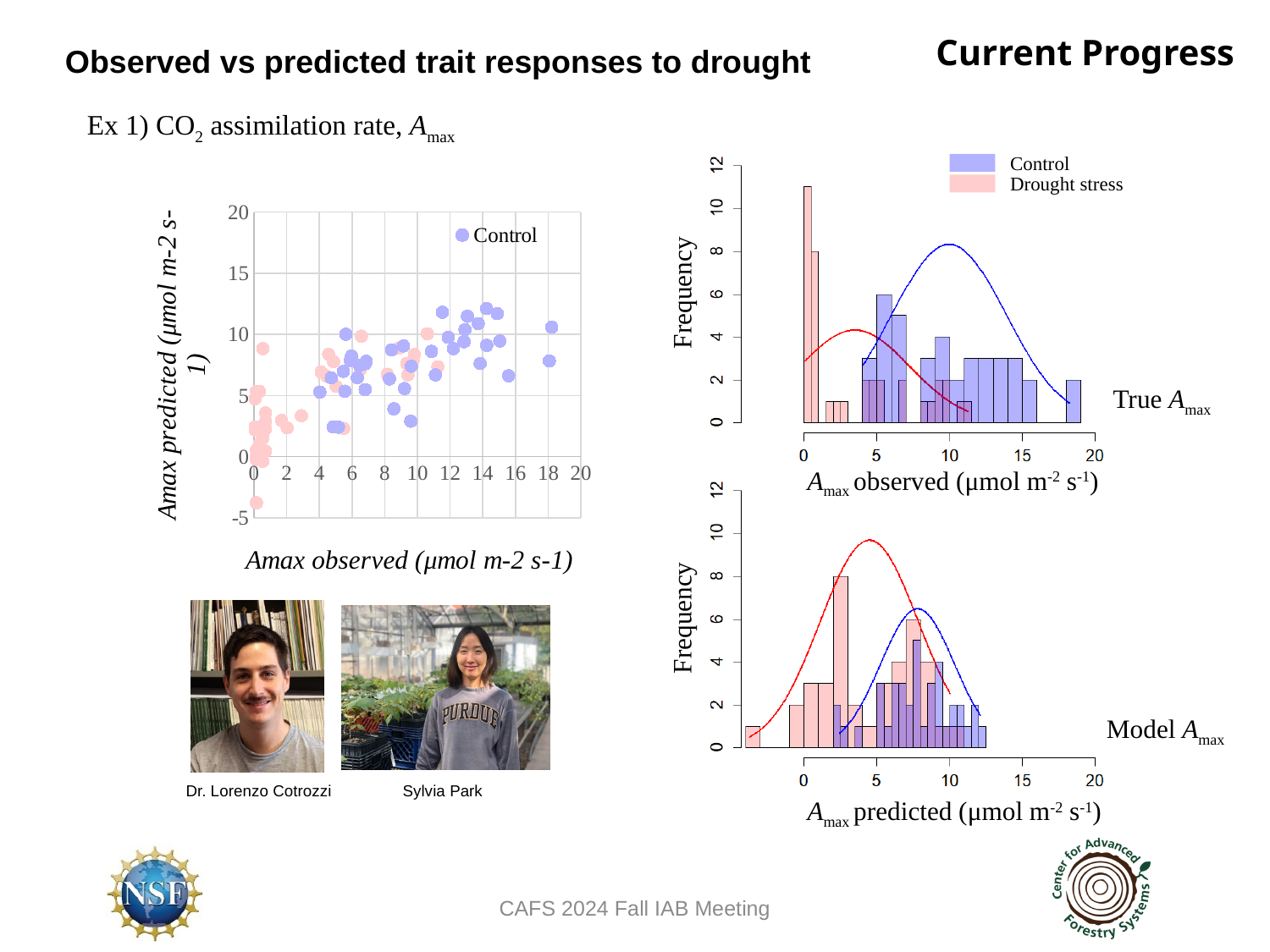
In the top right chart (True Amax), which group has the tallest bar, Control or Drought stress? Drought stress What kind of chart is the top right chart labelled True Amax? bar chart In the top right chart (True Amax), which colour represents the Control group? blue What are the two legend entries on the top right chart (True Amax)? Control, Drought stress In the bottom right chart (Model Amax), which group's bars are centred at higher predicted Amax values, Control or Drought stress? Control In the bottom right chart (Model Amax), is the frequency of the tallest Drought stress bar greater or less than 6? greater In the top right chart (True Amax), is the frequency of the tallest Drought stress bar greater or less than 10? greater In the left scatter chart, do the predicted Amax values generally rise or fall as observed Amax increases? rise In the top right chart (True Amax), is the frequency of the tallest Control bar greater or less than 4? greater How many series does the legend of the top right chart (True Amax) list? 2 What kind of chart is the left-hand chart with Amax observed on the x axis and Amax predicted on the y axis? scatter chart